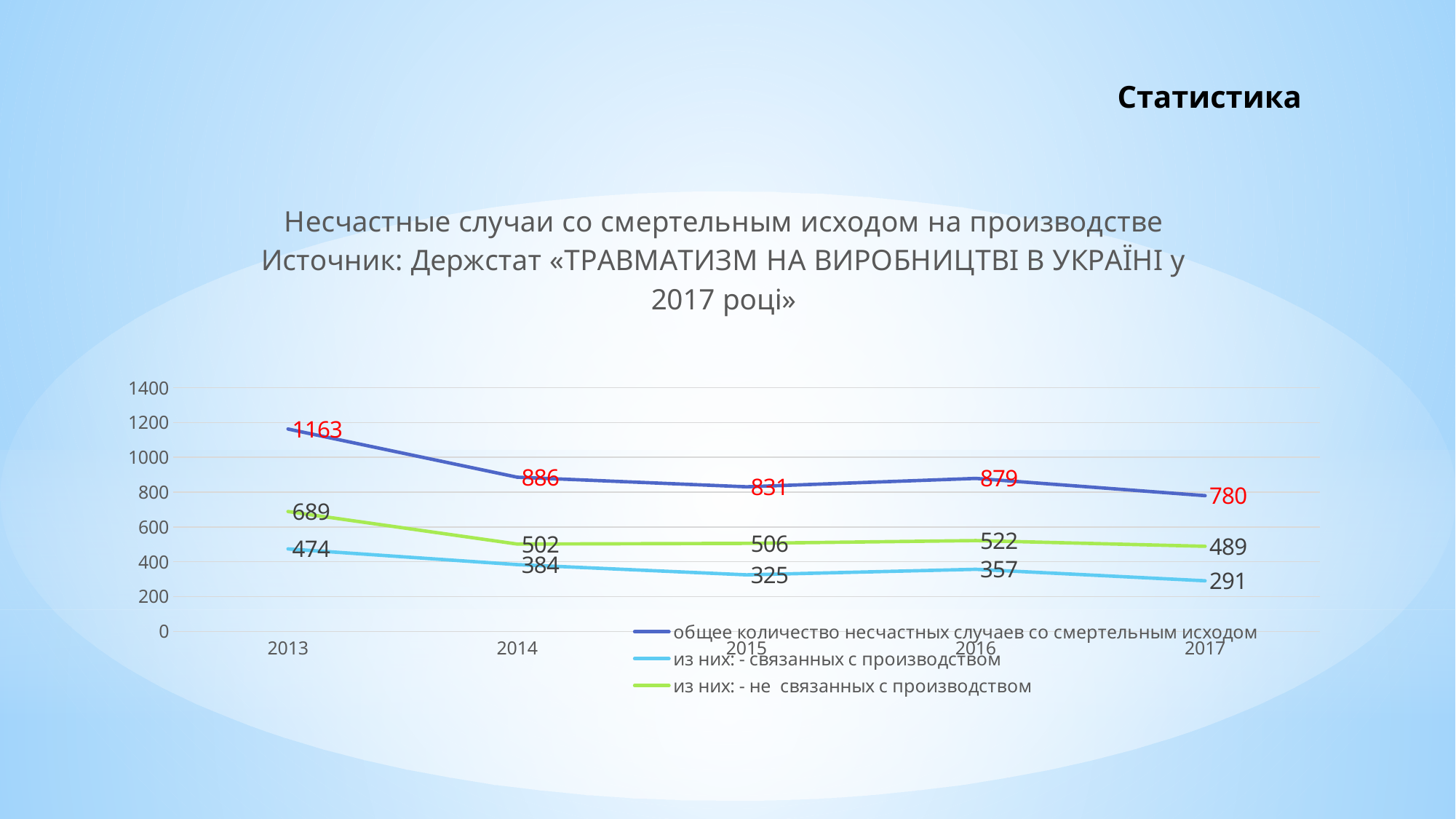
How many years are shown on the x axis? 5 In which year is the total number of fatal accidents the highest? 2013 Which is larger in 2016: the value for 'связанных с производством' or 'не связанных с производством'? не связанных с производством How many series does the legend list? 3 What type of chart is shown on the slide? line chart Does the total number of fatal accidents rise or fall from 2013 to 2014? fall What is the total number of fatal accidents (общее количество несчастных случаев со смертельным исходом) in 2013? 1163 What is the value for 'из них: - связанных с производством' in 2015? 325 What colour is the line for 'общее количество несчастных случаев со смертельным исходом'? dark blue In which year is the value for 'из них: - связанных с производством' the lowest? 2017 What is the value for 'из них: - не связанных с производством' in 2017? 489 What is the difference between the total number of fatal accidents in 2013 and in 2017? 383